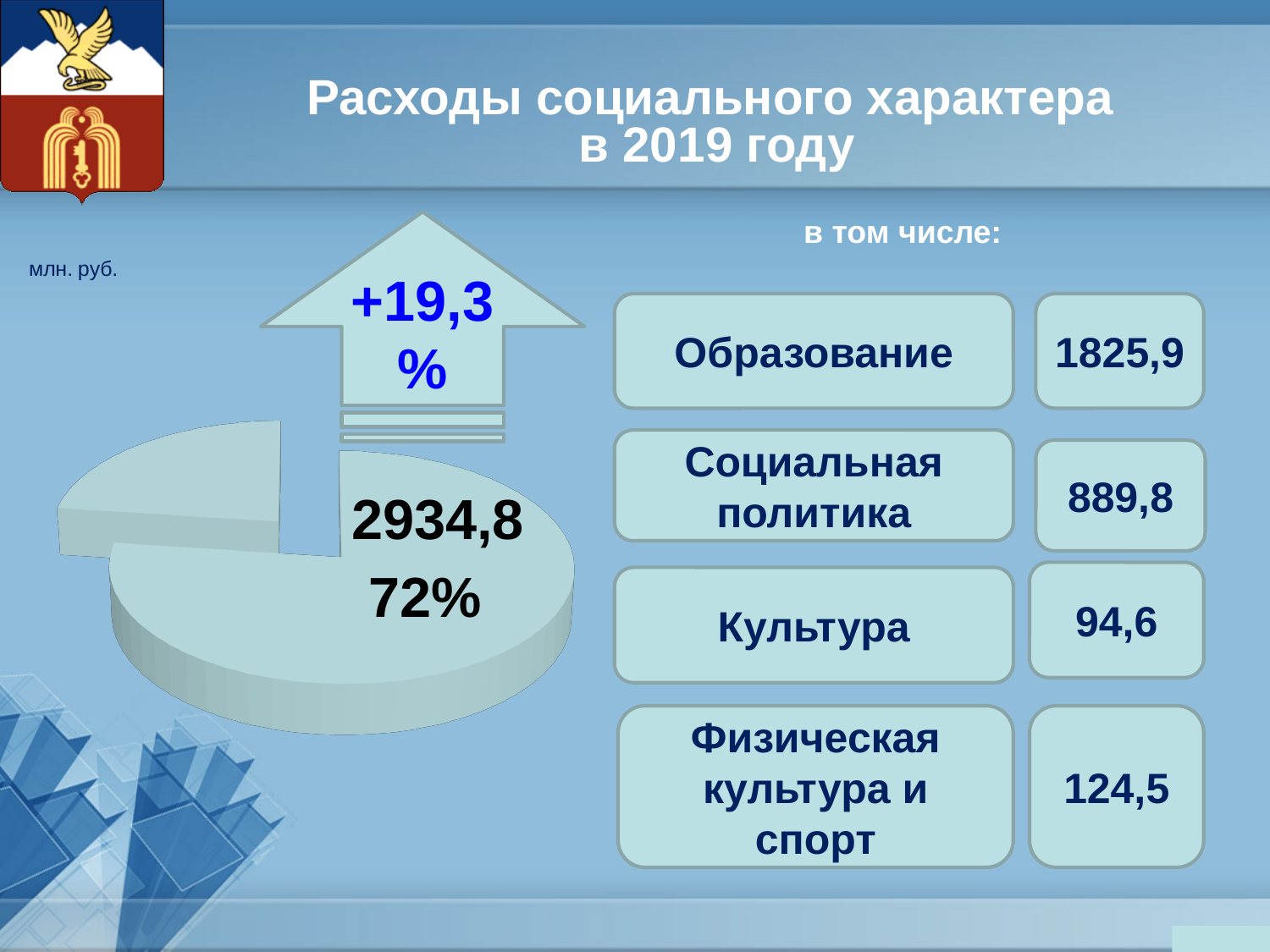
Which slice of the pie chart is larger, the labelled slice (72%) or the unlabelled slice? the labelled slice (72%) How many slices does the pie chart have? 2 What is the title of the slide containing the pie chart? Расходы социального характера в 2019 году Is the share of the labelled pie slice greater or less than 50%? greater In the breakdown boxes to the right of the pie chart, what value is given for Образование? 1825,9 What value is printed on the large exploded slice of the pie chart? 2934,8 In the breakdown boxes to the right of the pie chart, which category has the highest value? Образование What share of the pie does the labelled slice represent? 72% What unit is indicated for the values on the slide? млн. руб. What percentage change is shown in the arrow above the pie chart? +19,3 % What kind of chart is shown on the slide? pie chart In the breakdown boxes to the right of the pie chart, which category has the lowest value? Культура